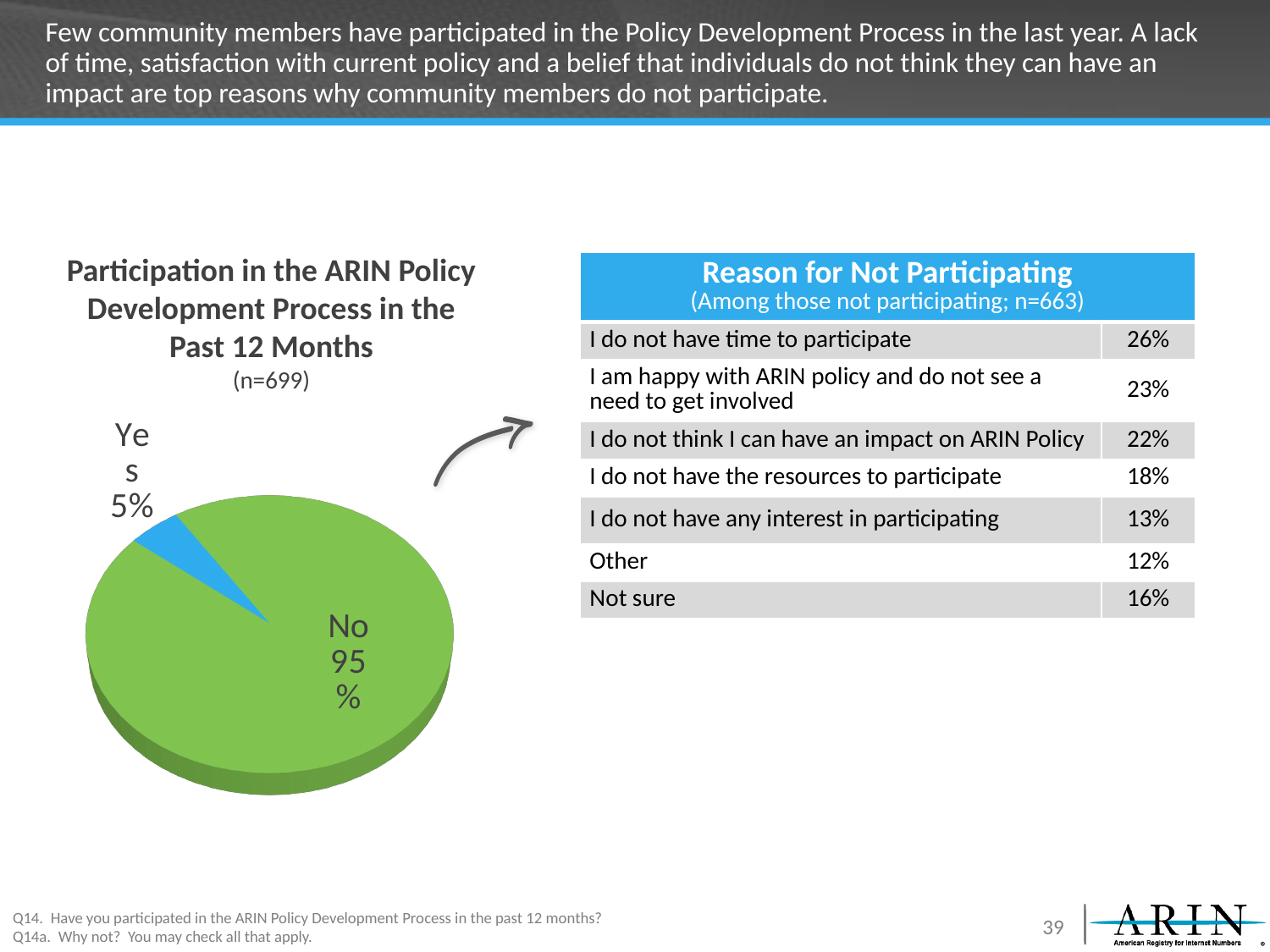
Which is larger in the pie chart, the "Yes" slice or the "No" slice? No Which slice of the pie chart is the largest? No What percentage of respondents answered "Yes" in the pie chart? 5% What percentage of respondents answered "No" in the pie chart? 95% What is the difference in percentage points between the "No" and "Yes" slices of the pie chart? 90 What kind of chart is shown on the slide? pie chart What share of the pie does the "No" slice represent? 95% Which slice of the pie chart is the smallest? Yes What is the sample size (n) shown under the pie chart's title? n=699 What colour is the "Yes" slice of the pie chart? blue How many slices does the pie chart have? 2